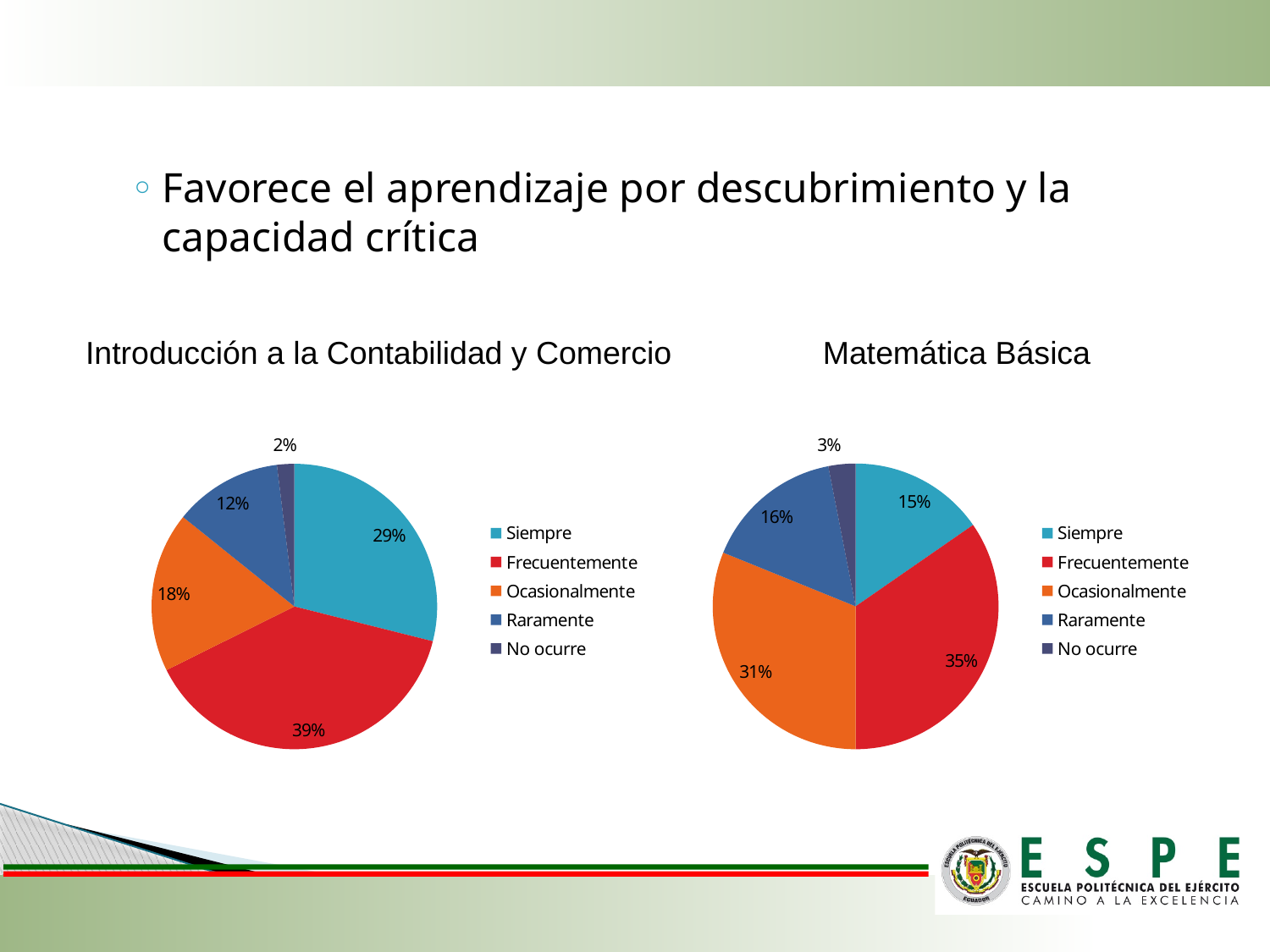
In the 'Introducción a la Contabilidad y Comercio' chart, what is the difference between the Frecuentemente and Siempre percentages? 10% What type of chart is used for 'Introducción a la Contabilidad y Comercio'? Pie chart How many categories does the 'Matemática Básica' chart have? 5 In the 'Matemática Básica' chart, what percentage is shown for Ocasionalmente? 31% In the 'Matemática Básica' chart, what percentage is shown for Siempre? 15% Which chart shows a larger share for Siempre, 'Introducción a la Contabilidad y Comercio' or 'Matemática Básica'? Introducción a la Contabilidad y Comercio In the 'Matemática Básica' chart, which category has the smallest share? No ocurre In the 'Introducción a la Contabilidad y Comercio' chart, which category has the largest share? Frecuentemente In the 'Matemática Básica' chart, what is the difference between the Frecuentemente and Ocasionalmente percentages? 4% In the 'Introducción a la Contabilidad y Comercio' chart, what percentage is shown for Raramente? 12% In the 'Matemática Básica' chart, which colour represents Ocasionalmente? Orange In the 'Introducción a la Contabilidad y Comercio' chart, what percentage is shown for Frecuentemente? 39%